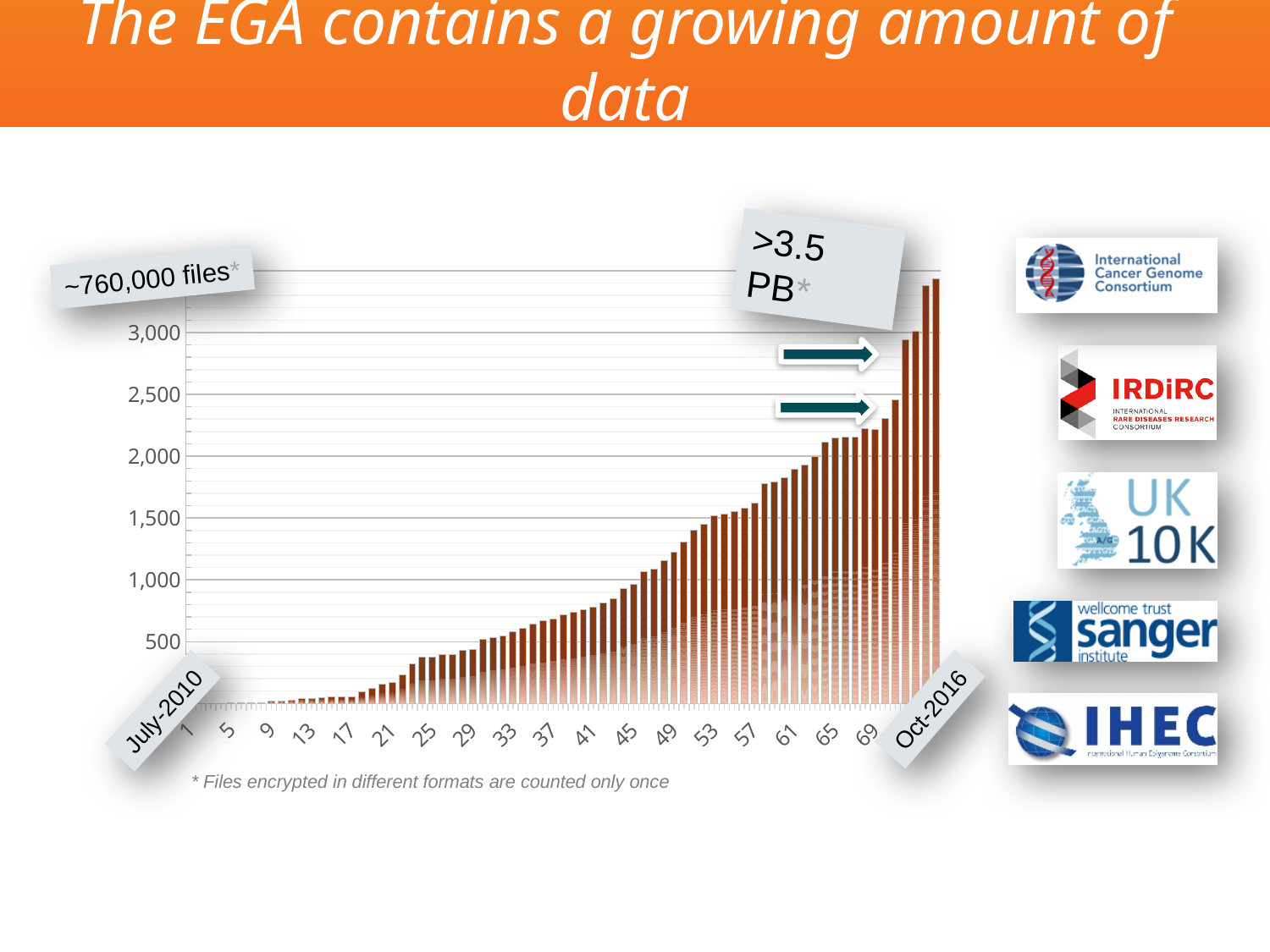
Is the value for category 41 greater or less than 1,000? less Which is larger, the value for category 33 or the value for category 53? category 53 Is the value of the last (rightmost) bar greater or less than 3,000? greater Is the value for category 21 greater or less than 500? less Do the bar values rise or fall from left to right along the x axis? rise What kind of chart is shown on the slide? bar chart What is the highest tick value shown on the y axis? 3,000 According to the annotation at the left of the chart, approximately how many files does the EGA contain? ~760,000 files Which bar on the chart is the tallest, the first one or the last one? the last one